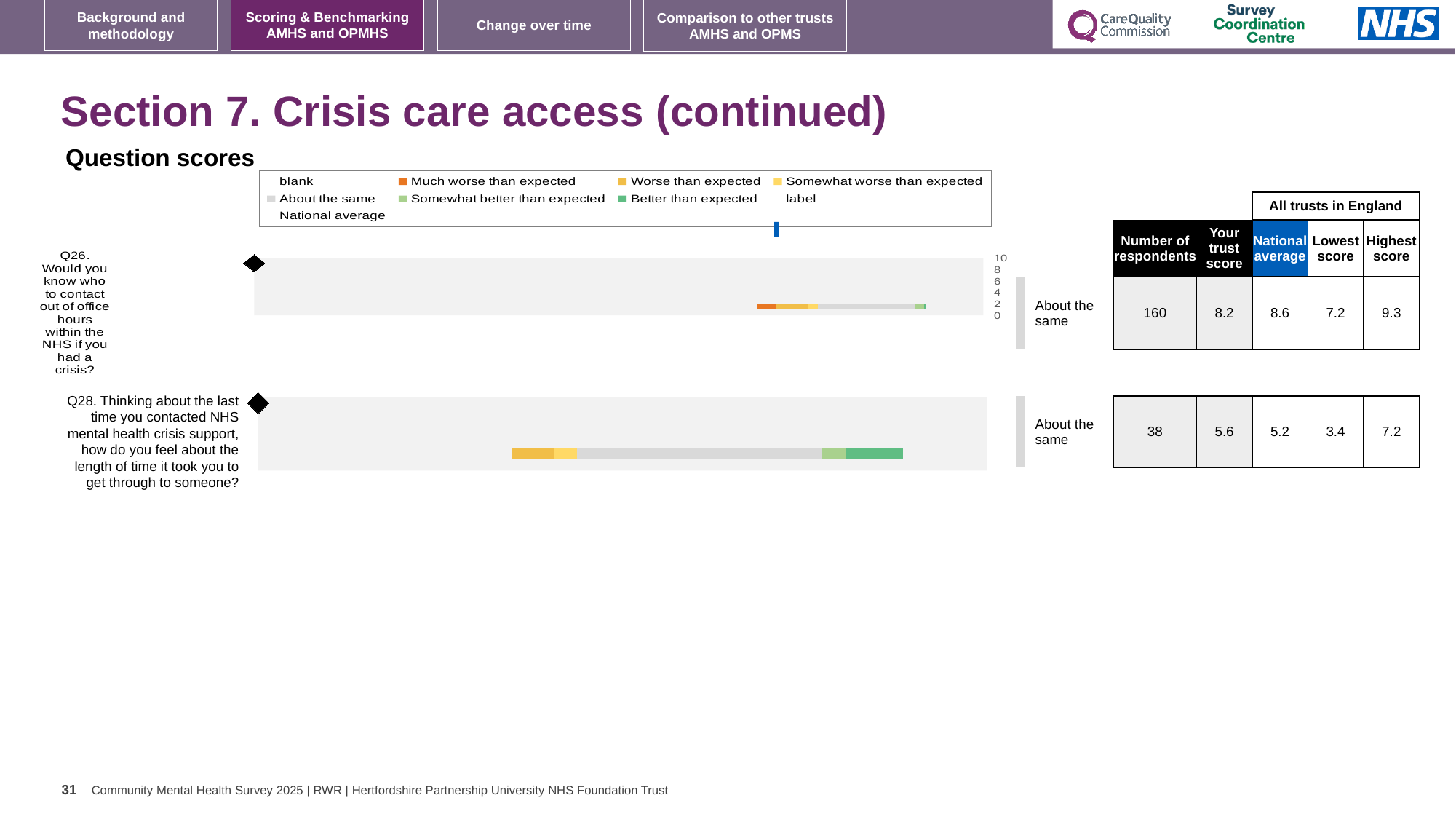
How many respondents are shown for Q28? 38 What is the national average for Q26? 8.6 What is the difference between the highest score and the lowest score for Q26? 2.1 What is the trust score for Q26? 8.2 How many questions are plotted in the question scores chart? 2 For Q28, which is larger: the trust score or the national average? trust score What is the lowest score among all trusts in England for Q28? 3.4 How many respondents are shown for Q26? 160 What is the trust score for Q28? 5.6 What benchmark category label is shown next to the Q28 bar? About the same For Q26, which is larger: the trust score or the national average? national average What kind of chart is used to show the question scores on this slide? bar chart